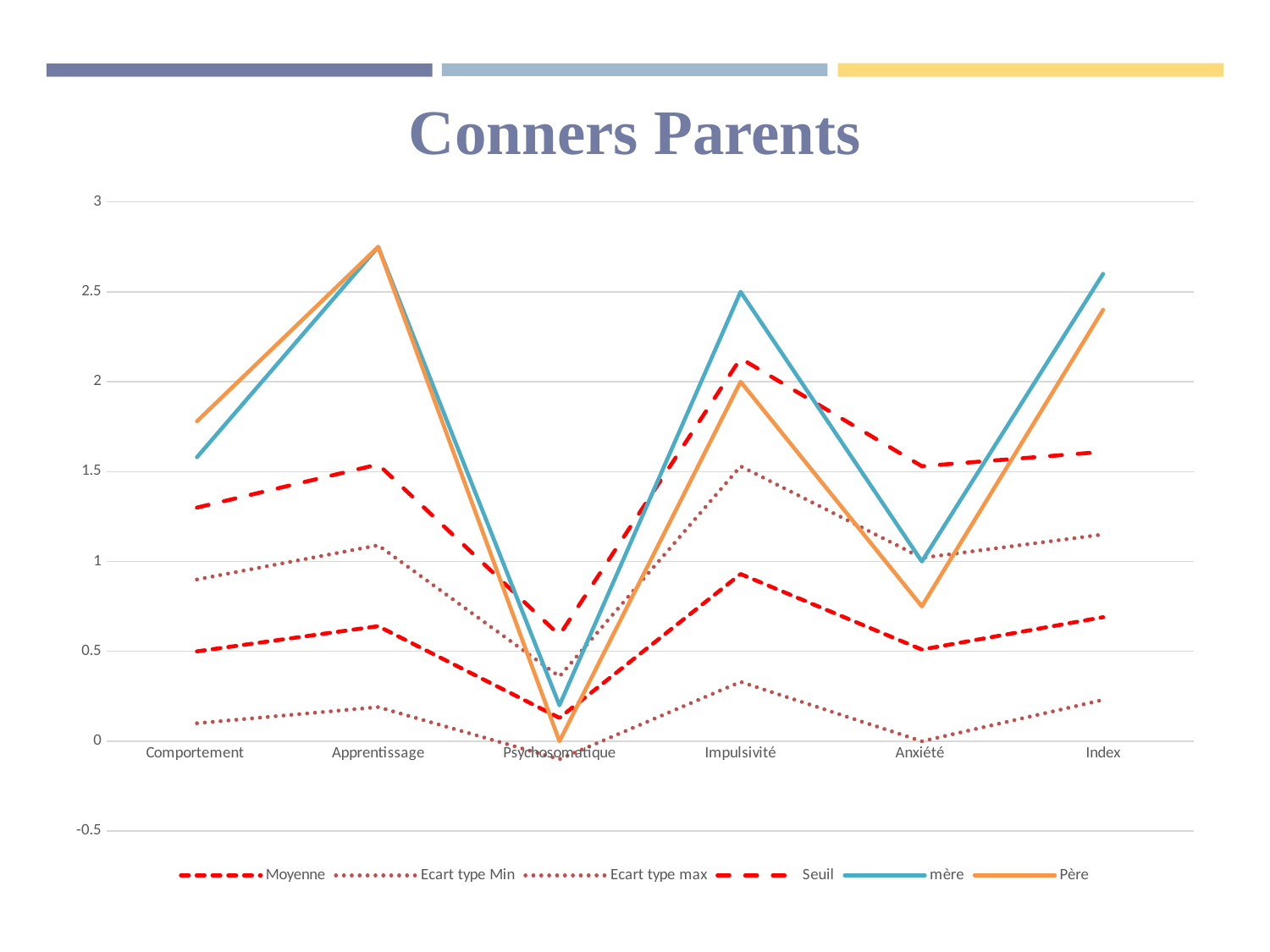
For the Père series, which category has the lowest value? Psychosomatique At Comportement, which is larger: the mère value or the Père value? Père How many categories are shown on the x axis? 6 What is the value of the mère series at Impulsivité? 2.5 At Index, which is larger: the mère value or the Père value? mère What is the title of the chart? Conners Parents What is the value of the Père series at Psychosomatique? 0 What type of chart is shown on the slide? line chart For the mère series, which category has the highest value? Apprentissage How many series does the legend list? 6 Is the value for Père at Comportement greater or less than 1.5? greater Is the value for mère at Psychosomatique greater or less than 0.5? less